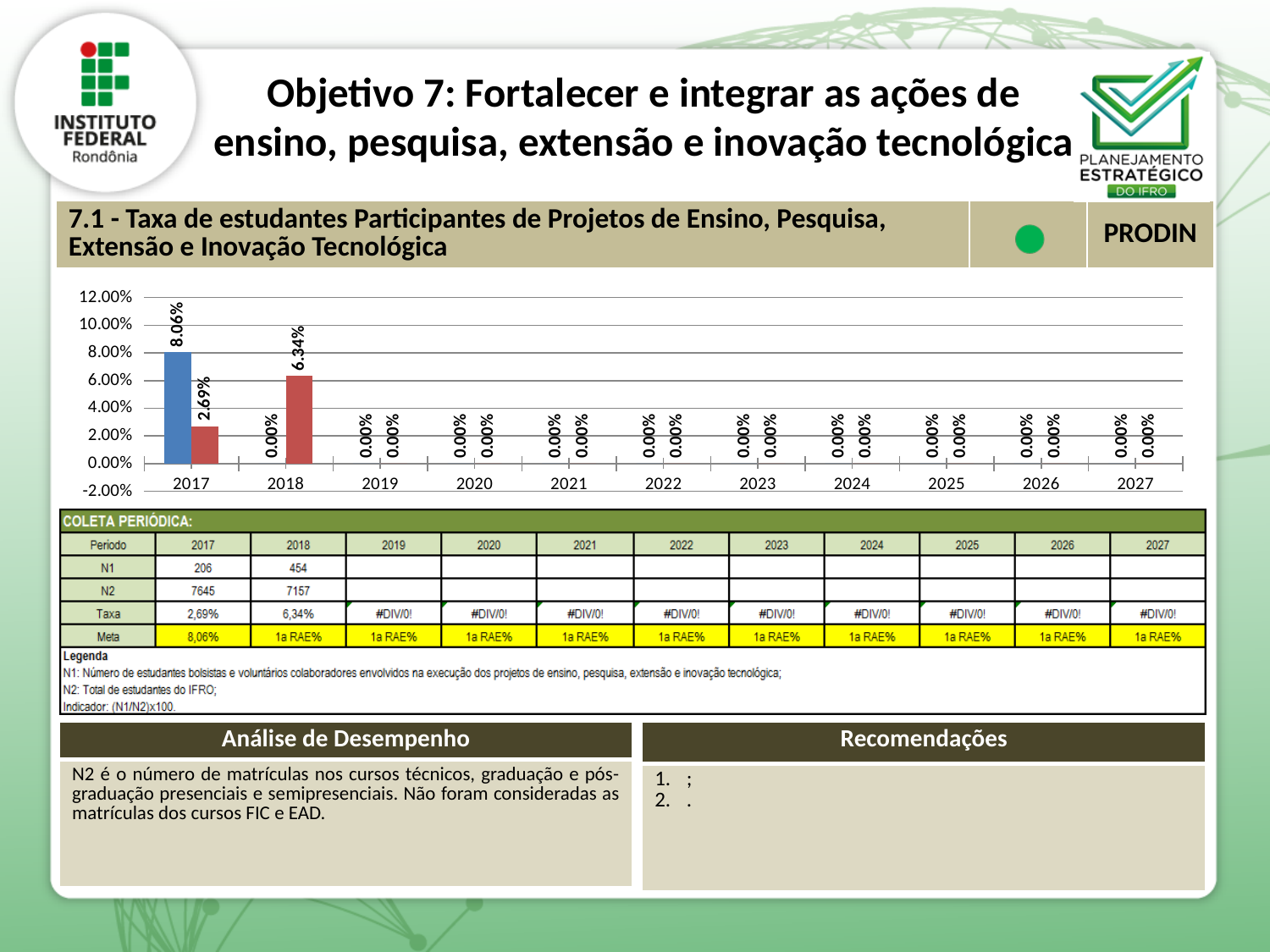
What is the value of the red bar for 2017? 2.69% What is the value of the blue bar for 2017? 8.06% What is the value of the red bar for 2025? 0.00% What is the value of the red bar for 2018? 6.34% Which year has the highest red bar? 2018 What is the value of the blue bar for 2018? 0.00% What type of chart is shown on the slide? bar chart Which is larger, the blue bar for 2017 or the red bar for 2018? the blue bar for 2017 What is the difference between the red bar for 2018 and the red bar for 2017? 3.65% What is the difference between the blue bar and the red bar for 2017? 5.37% How many years are shown on the x axis of the chart? 11 What is the highest value shown on the y axis of the chart? 12.00%